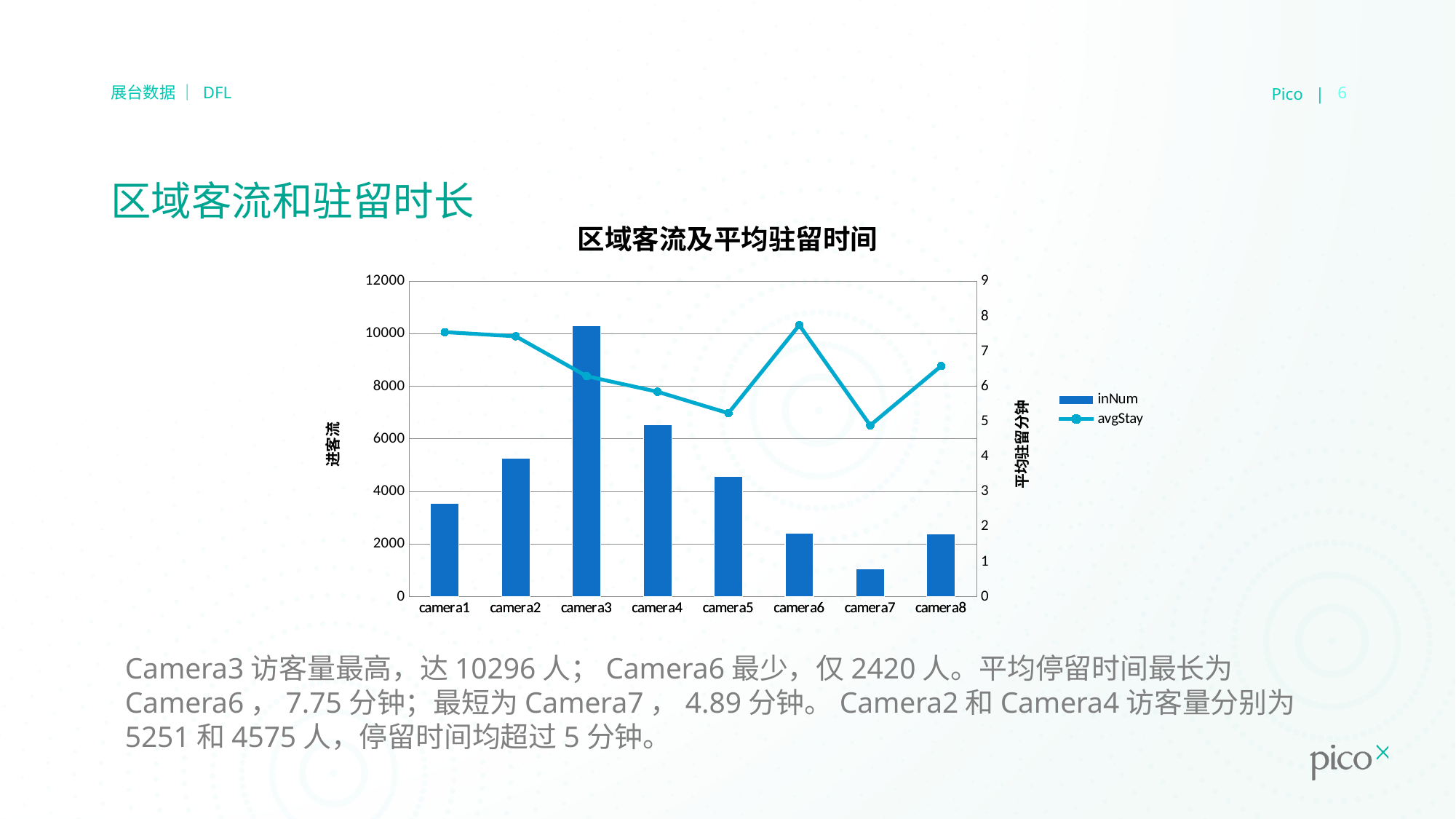
Is the inNum value for camera4 greater or less than 6000? greater Which camera has the lowest avgStay value? camera7 Does the avgStay line rise or fall from camera1 to camera5? fall Which camera has the lowest inNum bar? camera7 Which camera has the highest avgStay value? camera6 What is the title of the chart? 区域客流及平均驻留时间 Which has a larger inNum value, camera2 or camera5? camera2 Is the inNum value for camera1 greater or less than 4000? less How many series does the legend list? 2 How many cameras are shown on the x axis? 8 Which camera has the highest inNum bar? camera3 What kind of chart is shown on the slide? A bar chart combined with a line chart